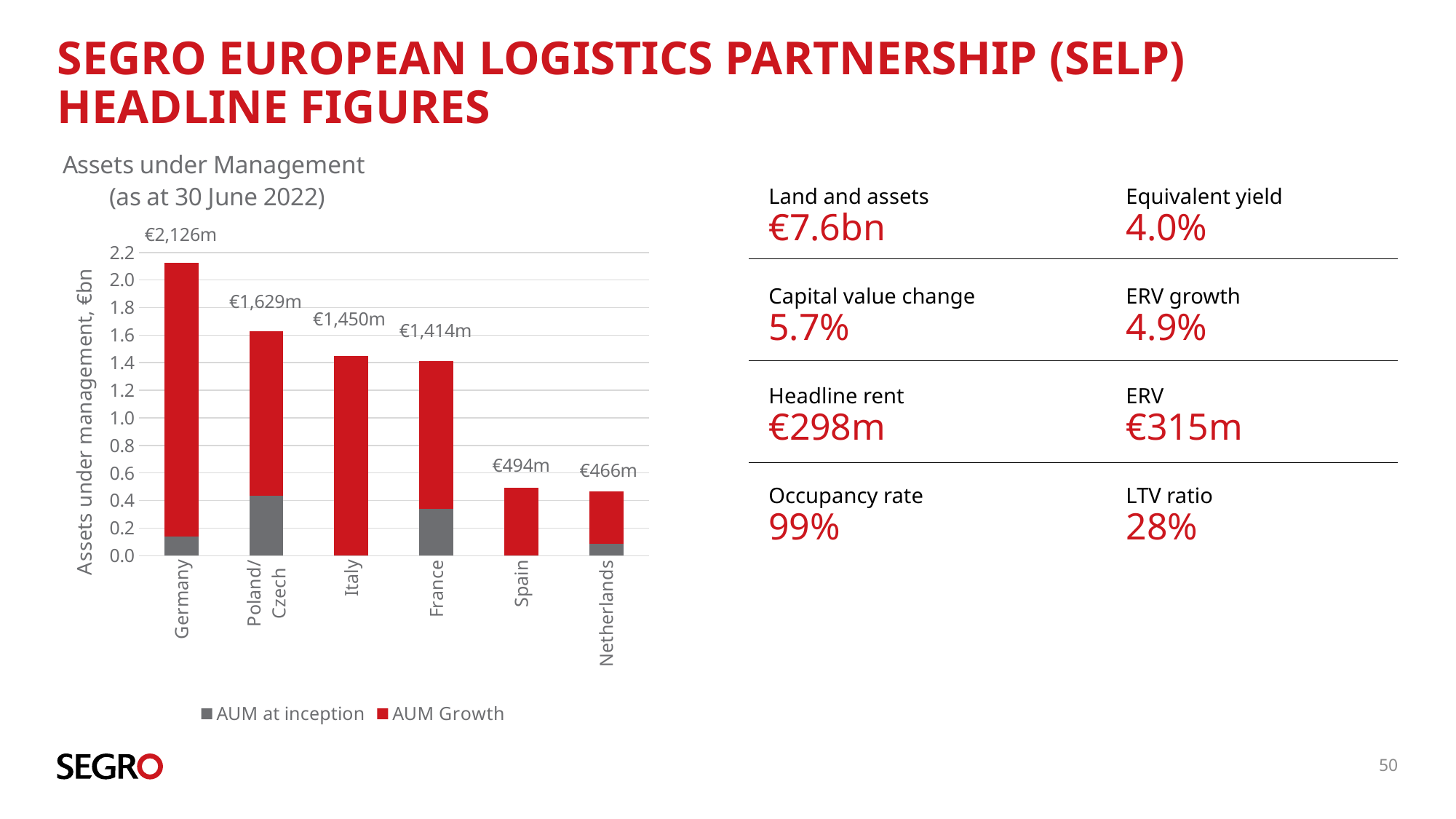
Which country has the lowest total assets under management? Netherlands What is the total assets under management for Netherlands? €466m Which has a larger total assets under management, Italy or France? Italy What is the total assets under management for Poland/Czech? €1,629m How many series does the chart legend list? 2 What type of chart is shown on the slide? Stacked bar chart Which country has the highest total assets under management? Germany What is the difference in total assets under management between Germany and Poland/Czech? €497m Which series is shown in red in the chart? AUM Growth Is the AUM at inception value for Poland/Czech greater or less than 0.2 €bn? greater What is the total assets under management for Germany? €2,126m How many countries or regions are shown on the x axis of the chart? 6